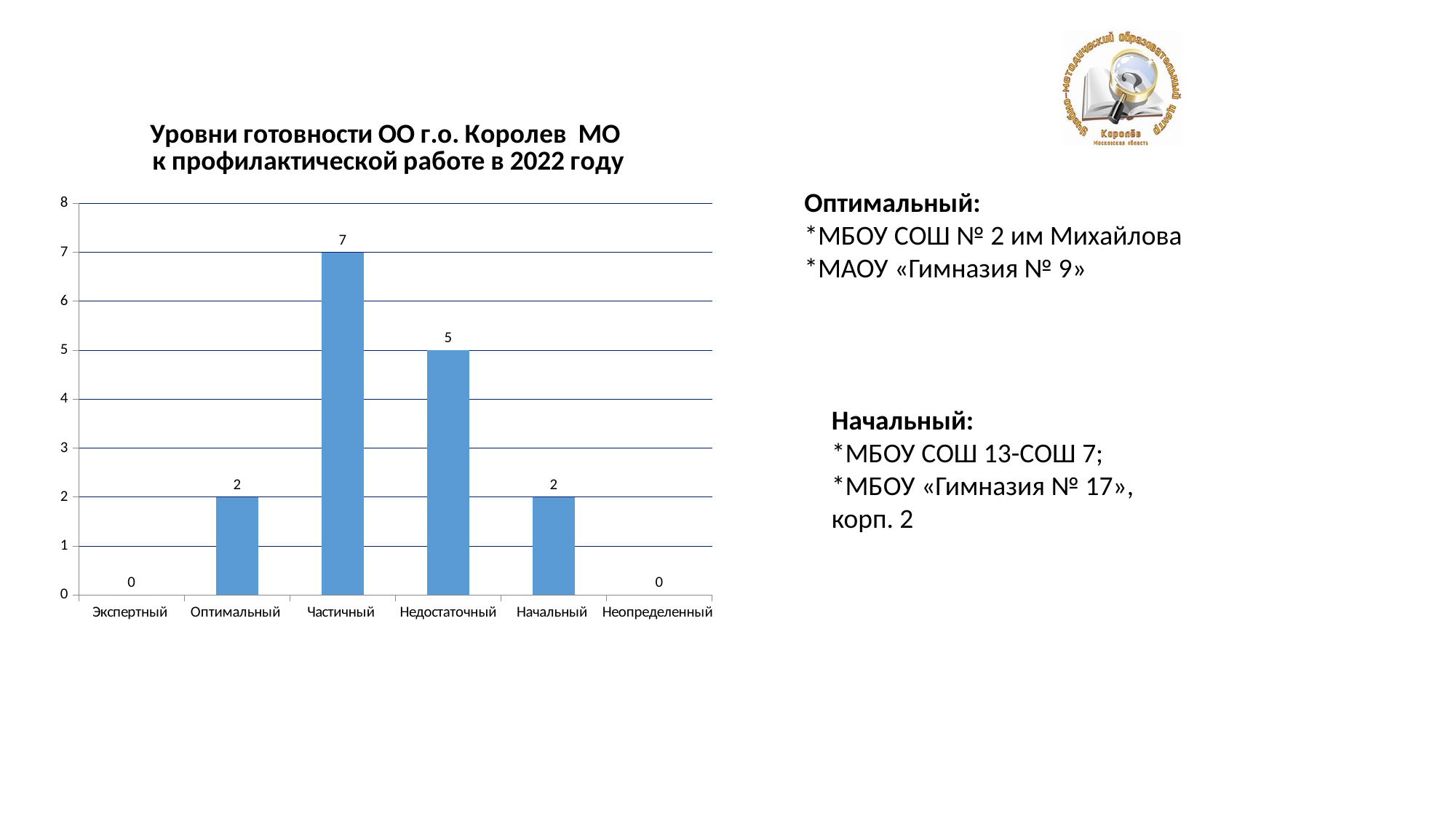
What is the title of the chart? Уровни готовности ОО г.о. Королев МО к профилактической работе в 2022 году Is the value for Частичный greater or less than 6? greater How many categories are shown on the x axis? 6 What is the value for Оптимальный? 2 Which category has the highest value? Частичный Which is larger, the value for Недостаточный or the value for Начальный? Недостаточный What is the value for Экспертный? 0 What kind of chart is shown on the slide? bar chart What is the value for Частичный? 7 What is the value for Недостаточный? 5 What is the difference between the values for Частичный and Недостаточный? 2 How many categories have a value of 0? 2